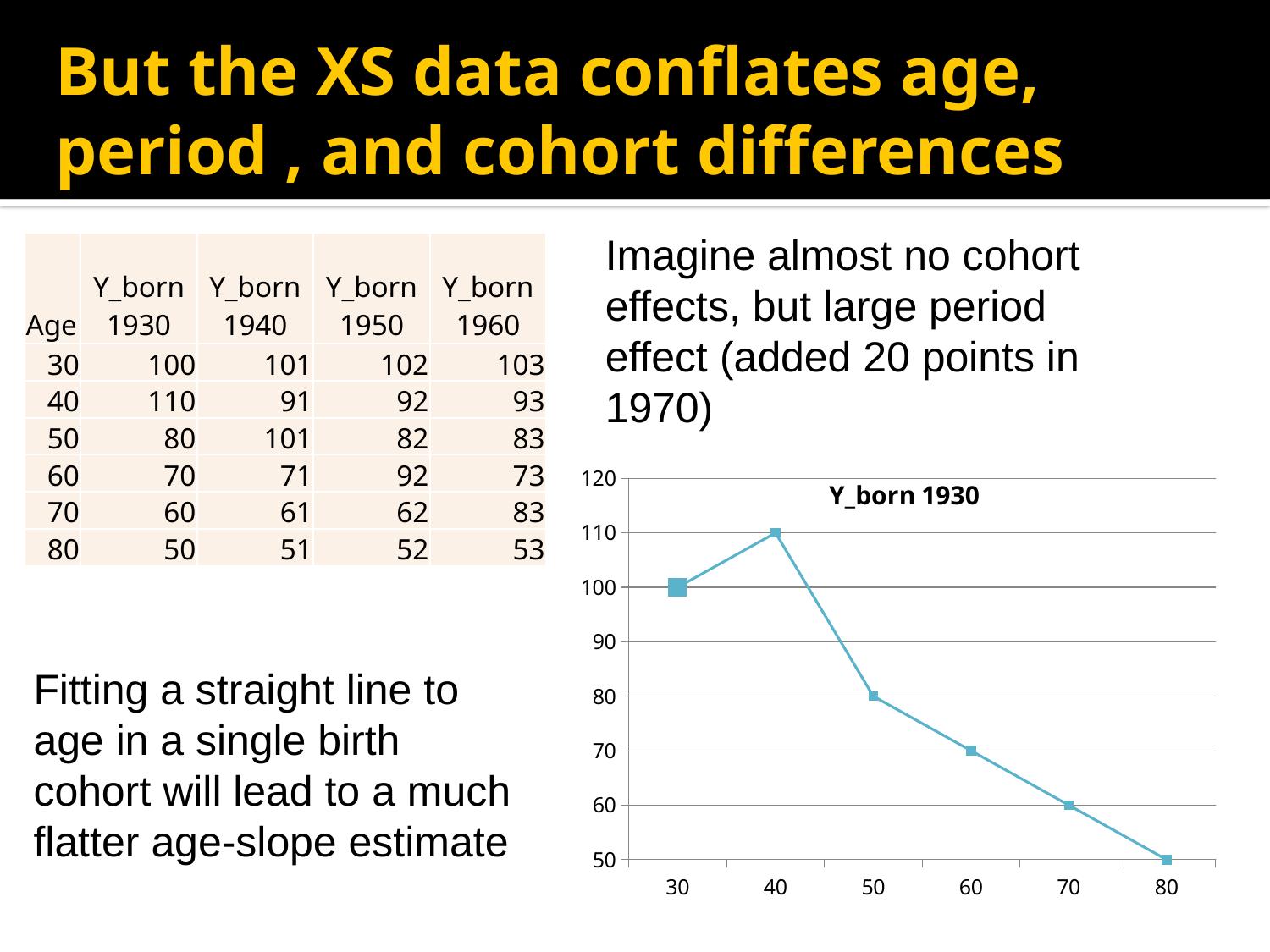
Which is larger, the value at age 30 or the value at age 60? age 30 What is the value at age 30 on the chart? 100 At which age is the plotted value highest? 40 What kind of chart is shown on the slide? line chart From age 40 to age 80, do the values rise or fall? fall What is the value at age 40 on the chart? 110 At which age is the plotted value lowest? 80 What is the value at age 50 on the chart? 80 What is the difference between the values at age 40 and age 50? 30 How many data points are plotted on the chart? 6 What is the title of the chart? Y_born 1930 What is the value at age 80 on the chart? 50